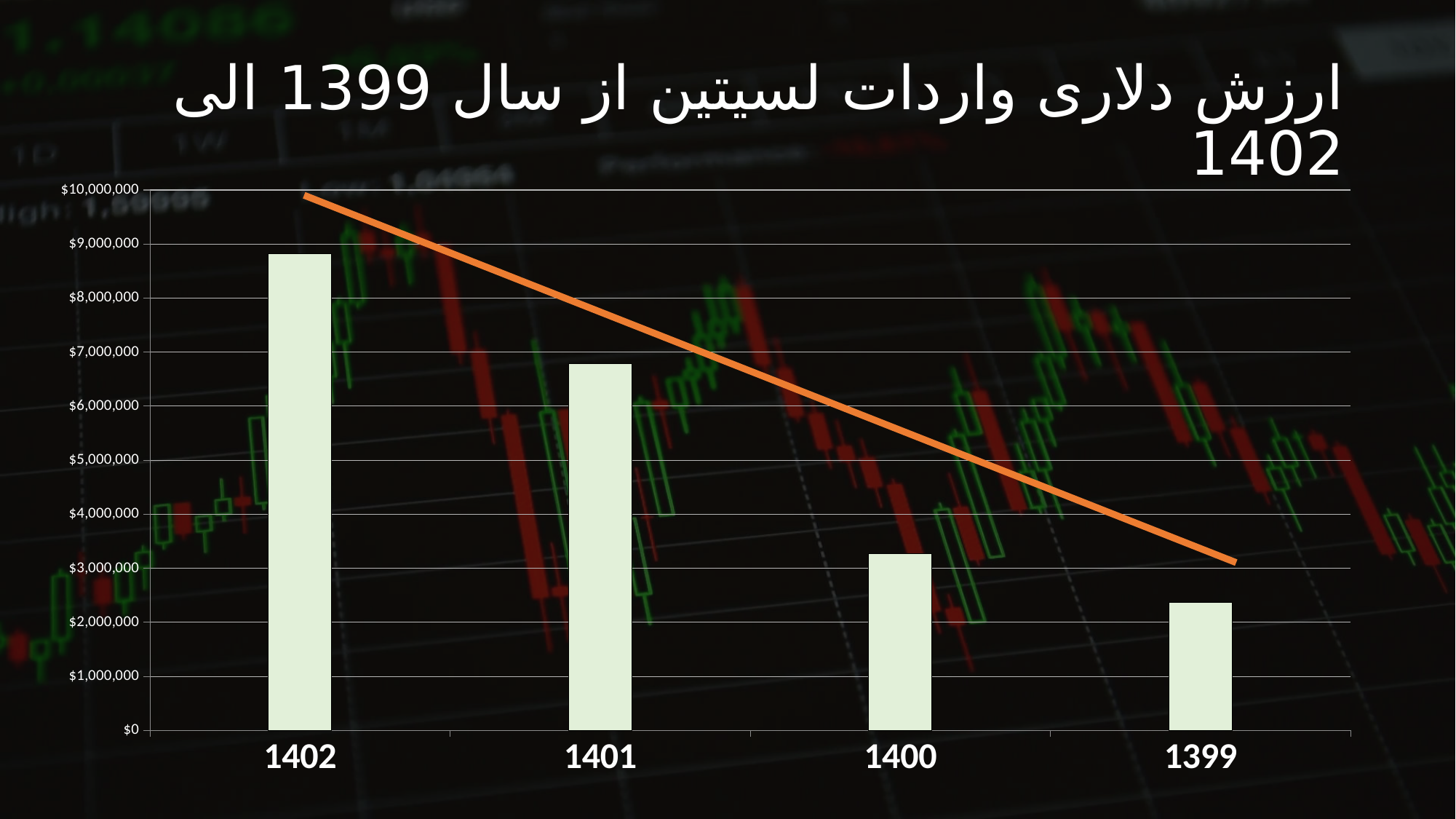
Which year has the highest bar? 1402 What is the highest value shown on the vertical axis? $10,000,000 Which is larger, the value for 1401 or the value for 1400? 1401 Do the bar values rise or fall moving from left to right along the x axis? fall What kind of chart is shown on the slide? bar chart How many bars (categories) does the chart show? 4 Is the value for 1399 greater or less than $3,000,000? less What colour is the straight trend line drawn across the chart? orange Which year has the lowest bar? 1399 Is the value for 1400 greater or less than $3,000,000? greater Is the value for 1402 greater or less than $8,000,000? greater